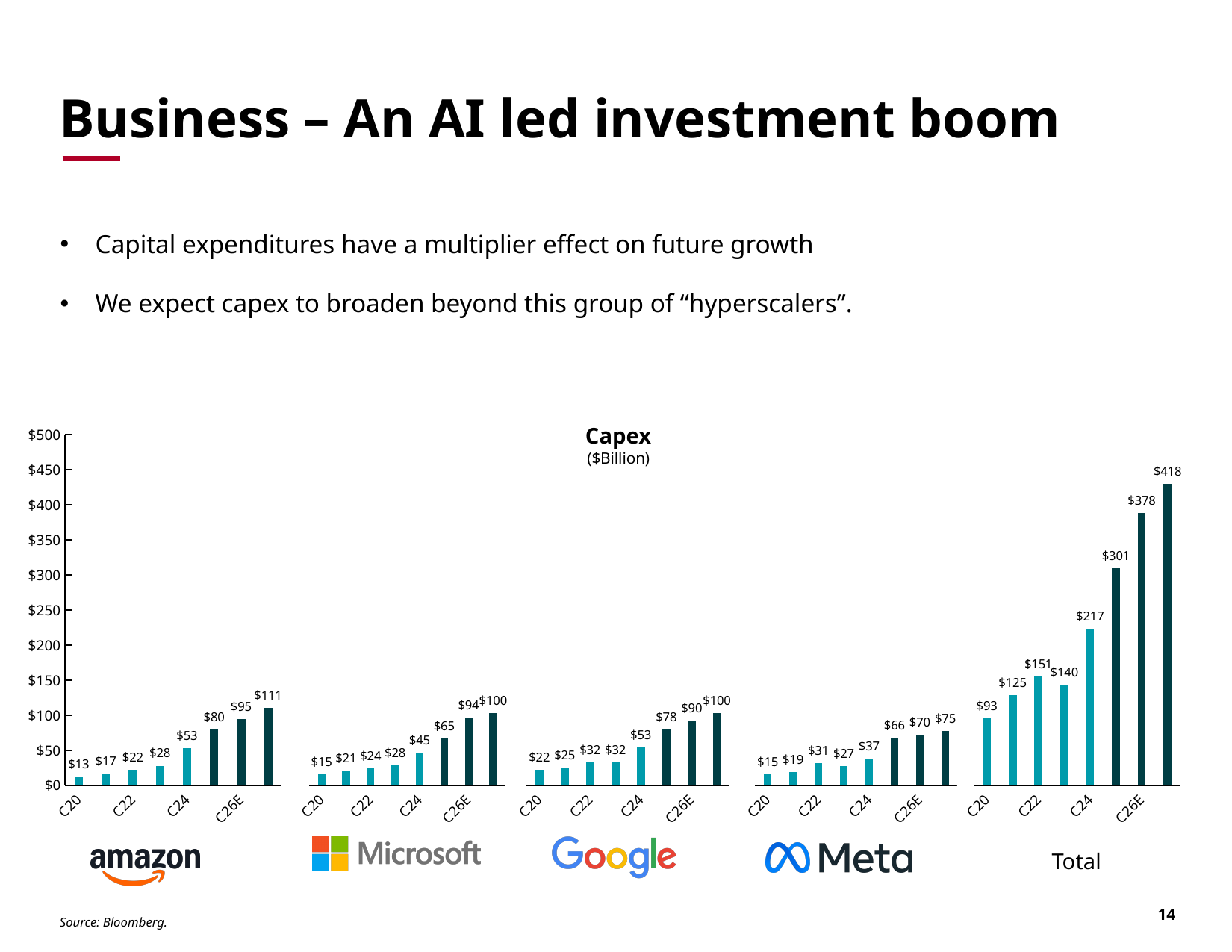
Which is larger: the rightmost bar for Amazon or the rightmost bar for Google? Amazon What kind of chart is shown on the slide? bar chart What is the value of the rightmost (C26E) bar in the Meta group? $75 Is the highest value in the Meta group greater or less than $100? less What is the highest value shown in the Total group? $418 In what units are the chart values expressed? $Billion Do the values in the Total group generally rise or fall from left to right? rise How many groups of bars are shown on the chart, including Total? 5 What is the value of the rightmost (C26E) bar in the Microsoft group? $100 What is the difference between the highest and lowest values in the Amazon group? $98 What is the title of the chart? Capex What is the lowest value shown in the Amazon group? $13